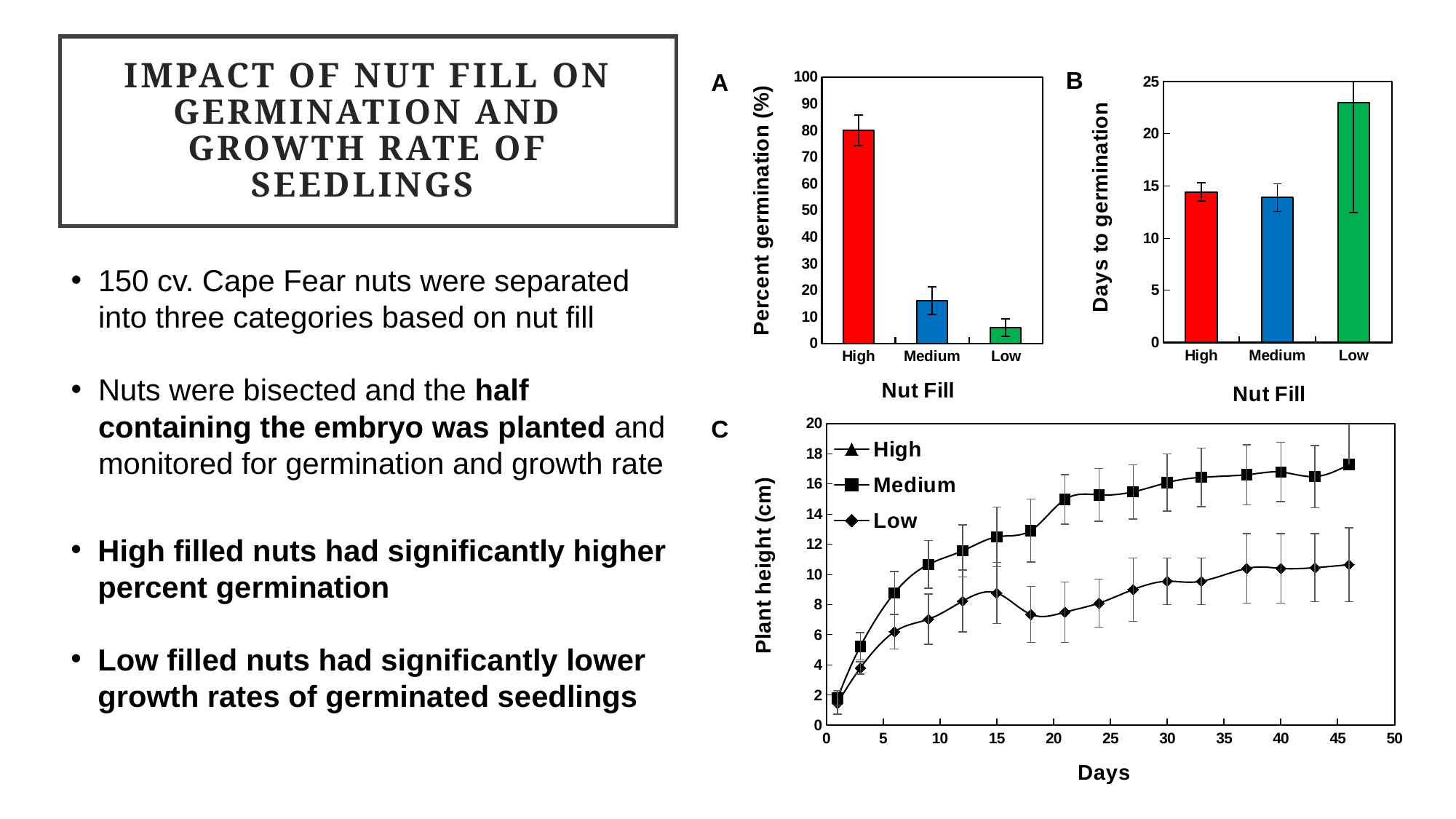
In chart A (Percent germination), is the value for High greater or less than 70? greater How many series does the legend of chart C (Plant height) list? 3 In chart B (Days to germination), which is larger, the value for Low or the value for High? Low How many nut fill categories are shown in chart A (Percent germination)? 3 In chart C (Plant height), does the Medium series rise or fall as Days increase? rise In chart A (Percent germination), which nut fill category has the lowest percent germination? Low In chart B (Days to germination), which nut fill category has the highest days to germination? Low What kind of chart is chart A (Percent germination)? bar chart In chart B (Days to germination), is the value for Low greater or less than 20? greater What kind of chart is chart C (Plant height)? line chart In chart A (Percent germination), is the value for Medium greater or less than 30? less In chart A (Percent germination), which nut fill category has the highest percent germination? High